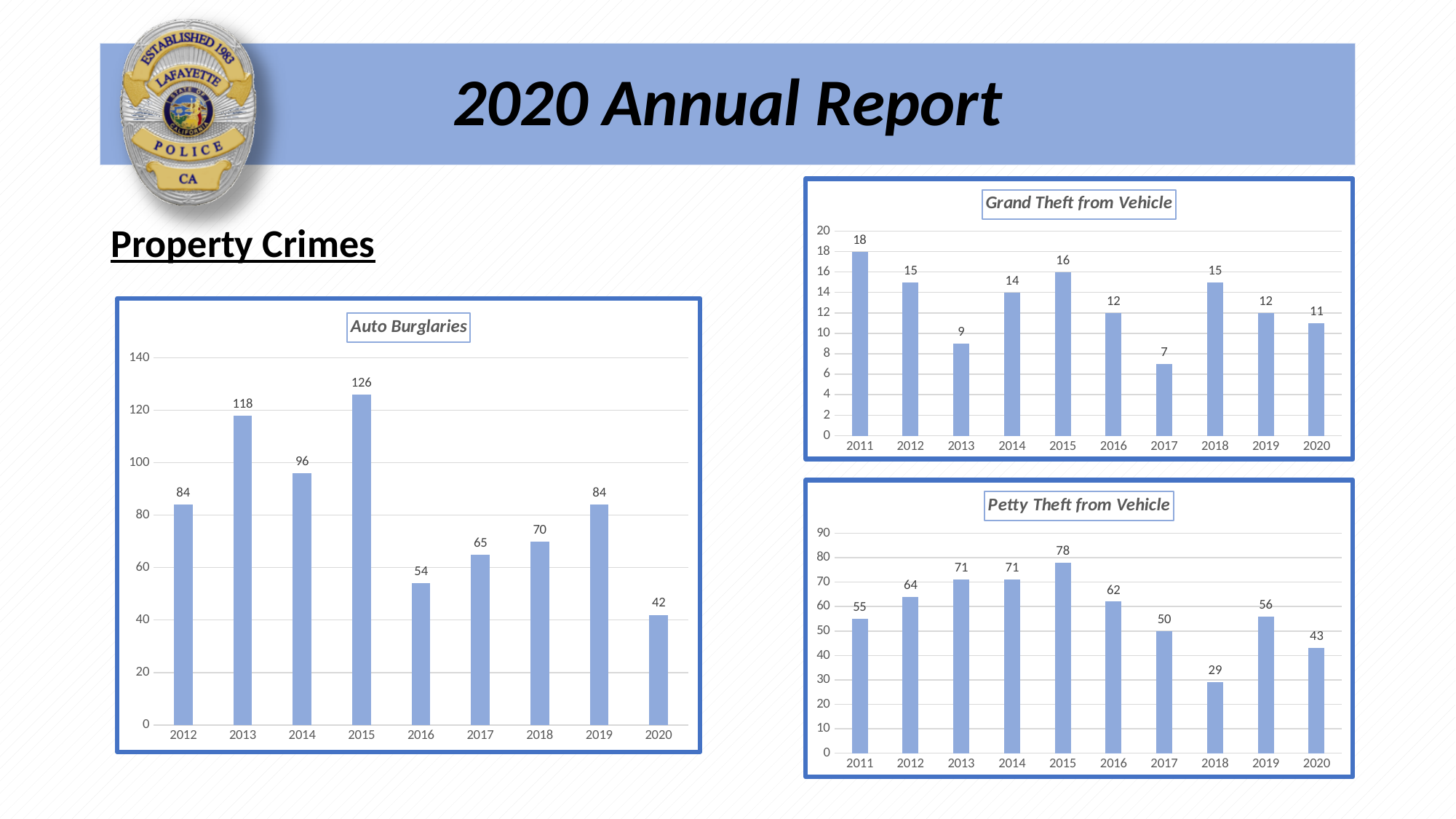
In the Auto Burglaries chart, how many years are plotted? 9 In the Petty Theft from Vehicle chart, what is the difference between the 2015 and 2020 values? 35 In the Auto Burglaries chart, what is the value for 2015? 126 In the Grand Theft from Vehicle chart, what is the value for 2017? 7 In the Grand Theft from Vehicle chart, how many years are plotted? 10 In the Auto Burglaries chart, which year has the lowest value? 2020 In the Grand Theft from Vehicle chart, which is larger, the value for 2014 or the value for 2016? 2014 In the Auto Burglaries chart, what is the difference between the 2013 and 2020 values? 76 In the Grand Theft from Vehicle chart, which year has the highest value? 2011 What kind of chart is the Petty Theft from Vehicle chart? Bar chart In the Petty Theft from Vehicle chart, which year has the highest value? 2015 In the Petty Theft from Vehicle chart, what is the value for 2018? 29